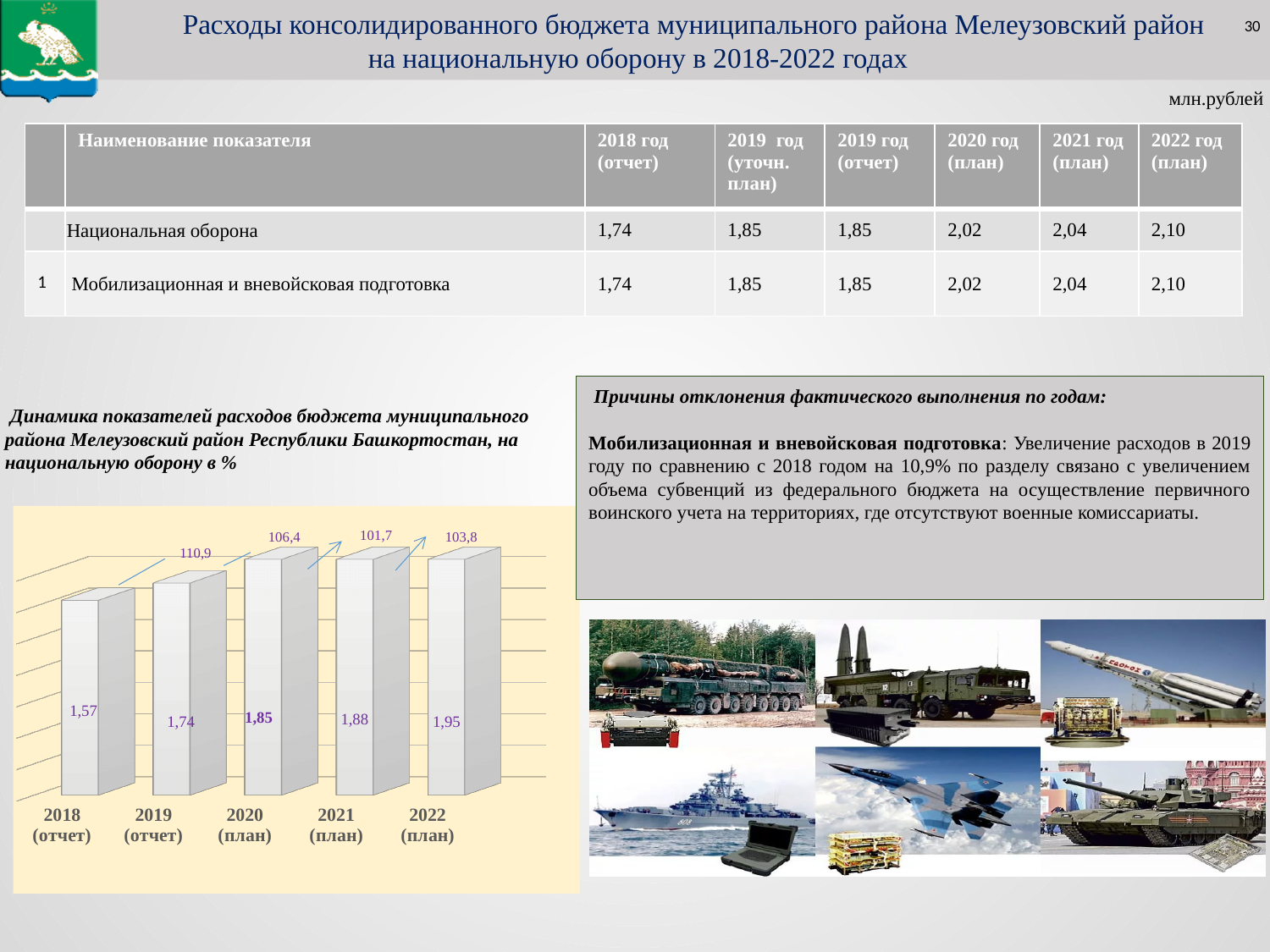
What percentage figure is shown above the bars between 2018 and 2019? 110,9 What type of chart is shown on the slide? bar chart Do the labelled bar values rise or fall from 2018 to 2022? rise What is the value labelled on the bar for 2022 (план)? 1,95 What is the value labelled on the bar for 2020 (план)? 1,85 What is the value labelled on the bar for 2019 (отчет)? 1,74 What is the difference between the labelled values for 2022 (план) and 2018 (отчет)? 0,38 How many bars (categories) does the chart show? 5 Which year has the highest labelled bar value in the chart? 2022 (план) Which year has the lowest labelled bar value in the chart? 2018 (отчет) What is the value labelled on the bar for 2018 (отчет)? 1,57 Which is larger, the labelled value for 2021 (план) or for 2020 (план)? 2021 (план)